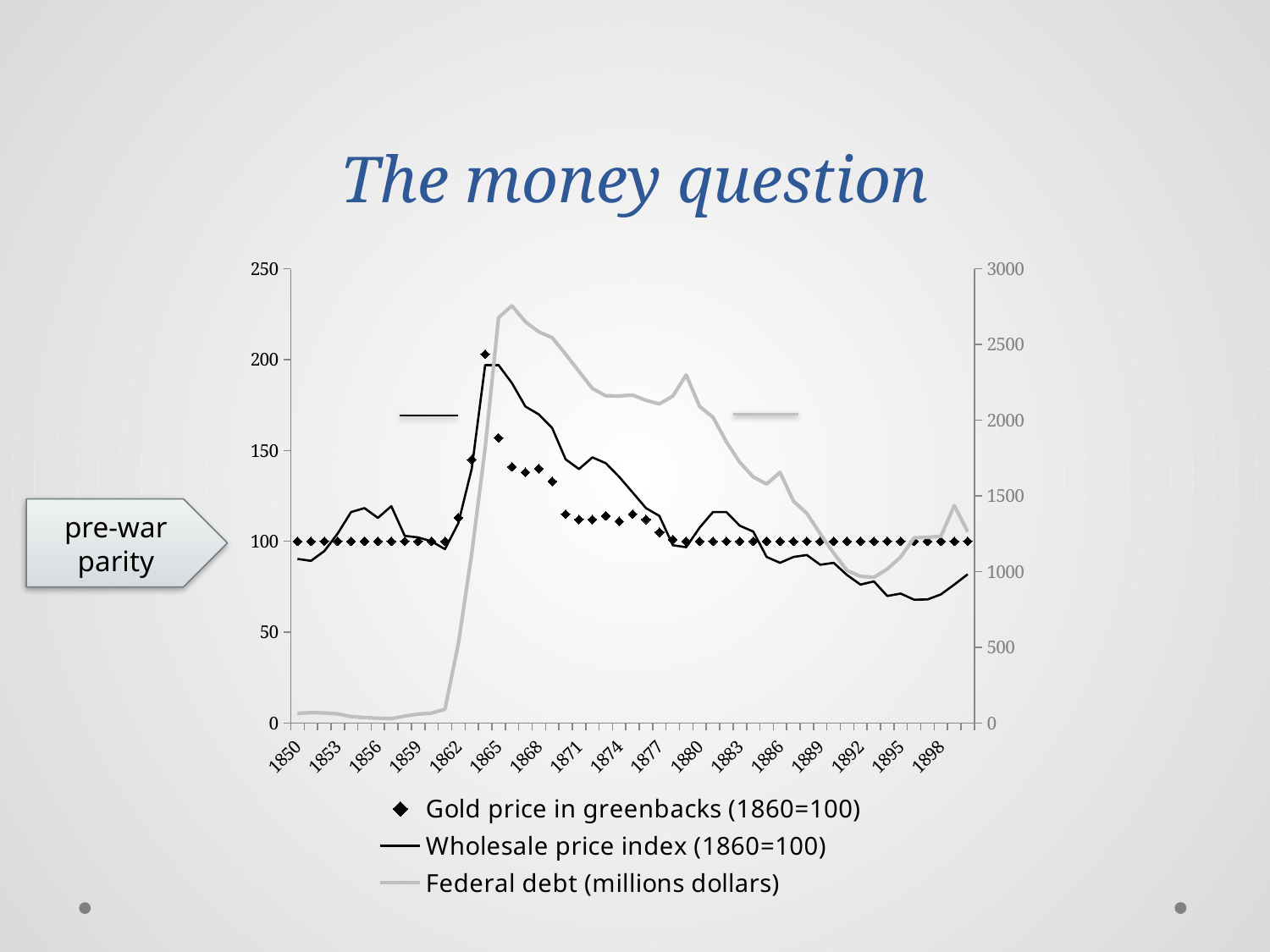
How many series does the legend list? 3 Is the value of Federal debt (millions dollars) in 1866 greater or less than 2500? greater What is the highest value shown on the right-hand axis? 3000 Is the value of Federal debt (millions dollars) in 1850 greater or less than 500? less Which series is plotted with diamond markers? Gold price in greenbacks (1860=100) Is the Wholesale price index (1860=100) higher in 1865 or in 1898? 1865 Is the Gold price in greenbacks (1860=100) in 1864 greater or less than 150? greater Is the Federal debt (millions dollars) higher in 1868 or in 1895? 1868 What kind of chart is shown on the slide? line chart Does the Federal debt (millions dollars) rise or fall between 1868 and 1892? fall